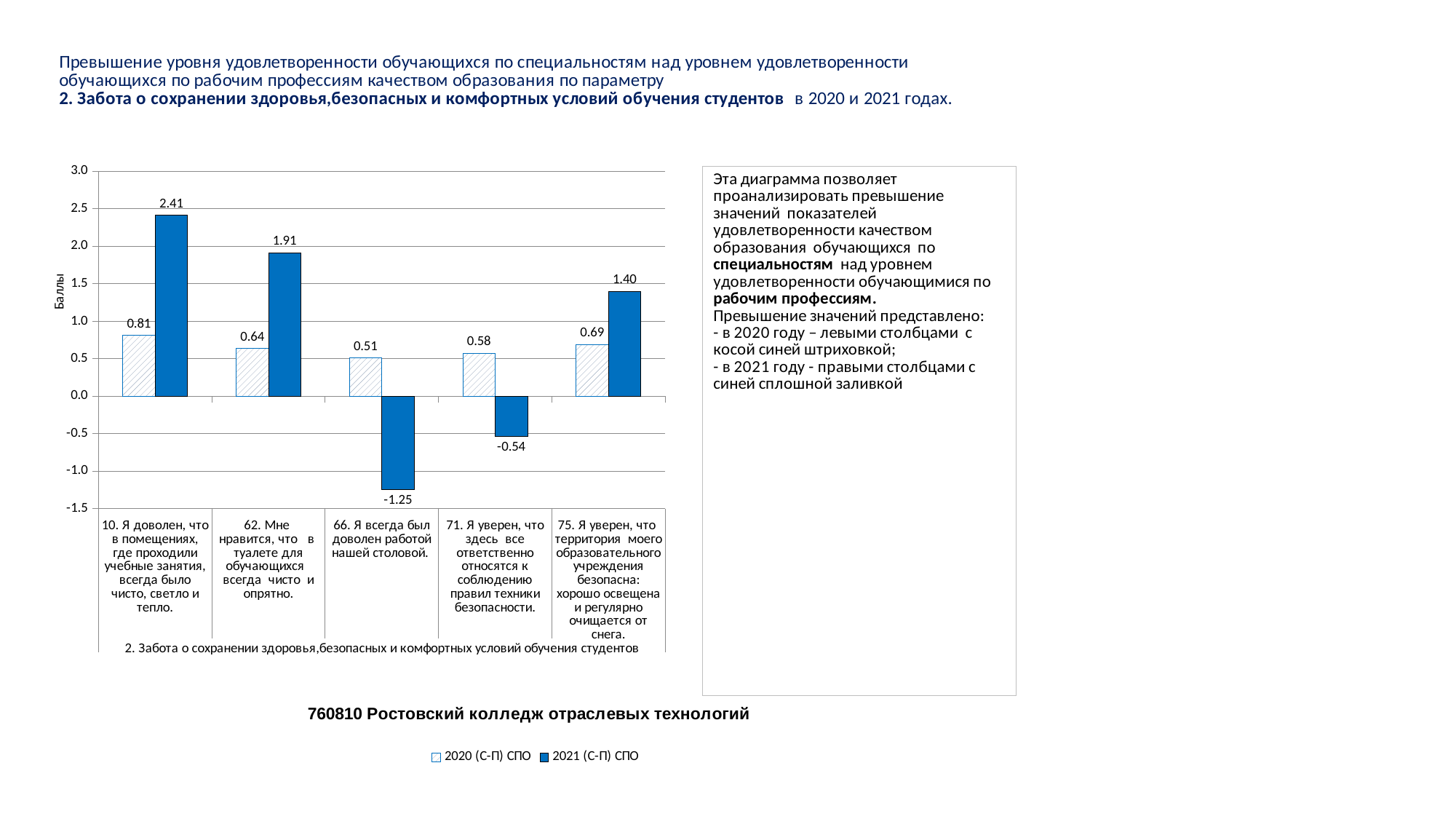
What is the 2020 (С-П) СПО value for item 62 ("Мне нравится, что в туалете для обучающихся всегда чисто и опрятно")? 0.64 What is the difference between the 2021 and 2020 (С-П) СПО values for item 75 ("Я уверен, что территория моего образовательного учреждения безопасна")? 0.71 For item 62, which series has the larger value: 2020 (С-П) СПО or 2021 (С-П) СПО? 2021 (С-П) СПО What is the label of the vertical axis of the chart? Баллы What is the 2021 (С-П) СПО value for item 71 ("Я уверен, что здесь все ответственно относятся к соблюдению правил техники безопасности")? -0.54 How many series does the chart legend list? 2 What type of chart is shown on the slide? Bar chart Which item has the lowest 2020 (С-П) СПО value? 66. Я всегда был доволен работой нашей столовой. Which item has the highest 2021 (С-П) СПО value? 10. Я доволен, что в помещениях, где проходили учебные занятия, всегда было чисто, светло и тепло. What is the 2021 (С-П) СПО value for item 66 ("Я всегда был доволен работой нашей столовой")? -1.25 What is the 2021 (С-П) СПО value for item 10 ("Я доволен, что в помещениях, где проходили учебные занятия, всегда было чисто, светло и тепло")? 2.41 How many items (categories) are shown on the x axis of the chart? 5